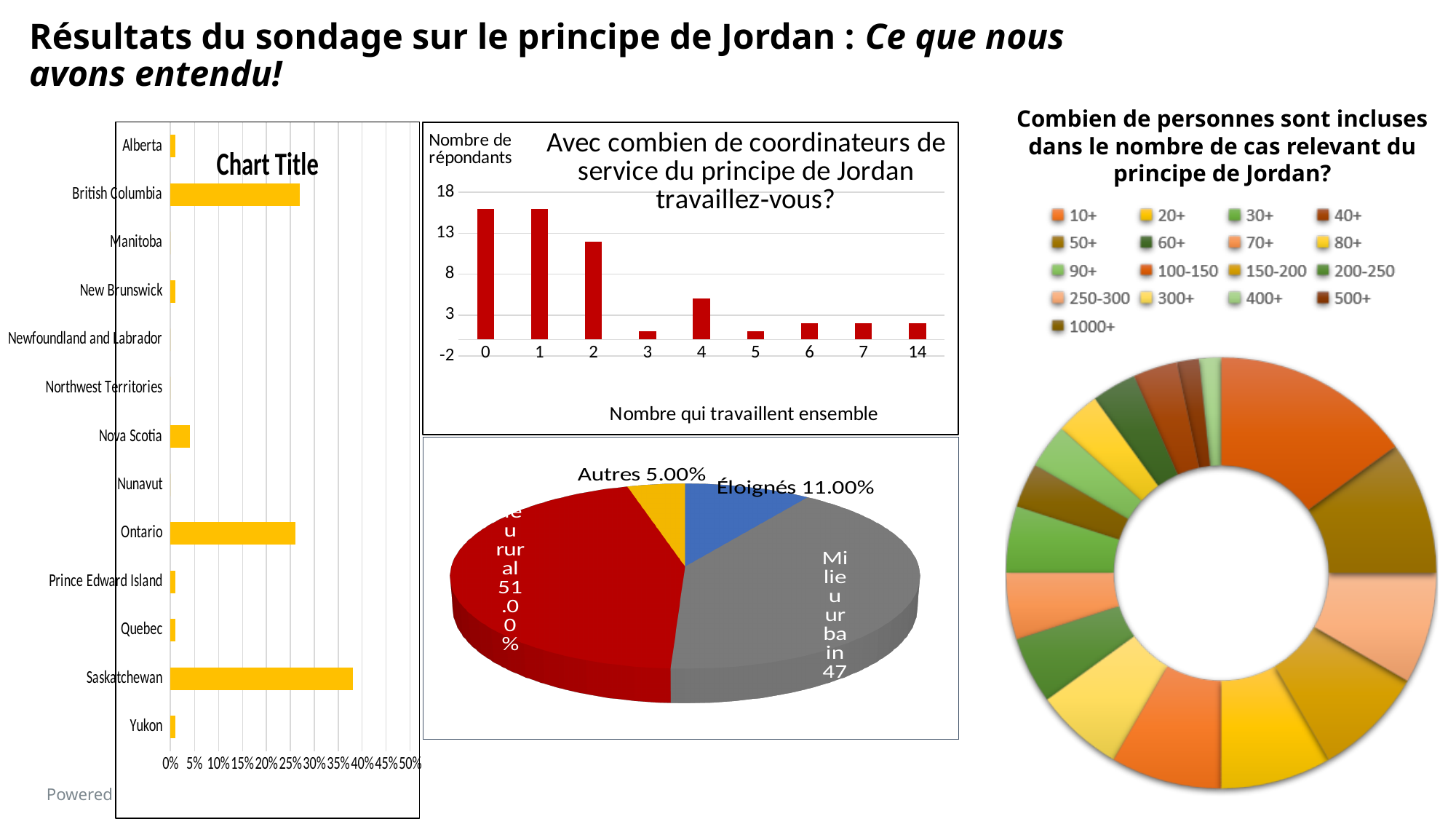
In the chart on the left titled "Chart Title", which province or territory has the highest value? Saskatchewan In the chart titled "Avec combien de coordinateurs de service du principe de Jordan travaillez-vous?", how many categories are shown on the x axis? 9 In the pie chart in the middle bottom of the slide, what share does the "Éloignés" slice have? 11.00% In the chart titled "Avec combien de coordinateurs de service du principe de Jordan travaillez-vous?", is the value for category 2 greater or less than 8? greater In the chart on the left titled "Chart Title", is the value for Ontario greater or less than 30%? less In the pie chart in the middle bottom of the slide, what share does the "Autres" slice have? 5.00% What kind of chart is the chart on the left of the slide titled "Chart Title"? bar chart In the chart on the left titled "Chart Title", which is larger, the value for British Columbia or the value for Nova Scotia? British Columbia In the chart on the left titled "Chart Title", is the value for Saskatchewan greater or less than 30%? greater How many provinces and territories are listed as categories in the chart on the left titled "Chart Title"? 13 In the chart titled "Avec combien de coordinateurs de service du principe de Jordan travaillez-vous?", what is the x-axis title? Nombre qui travaillent ensemble In the doughnut chart titled "Combien de personnes sont incluses dans le nombre de cas relevant du principe de Jordan?", how many entries does the legend list? 17